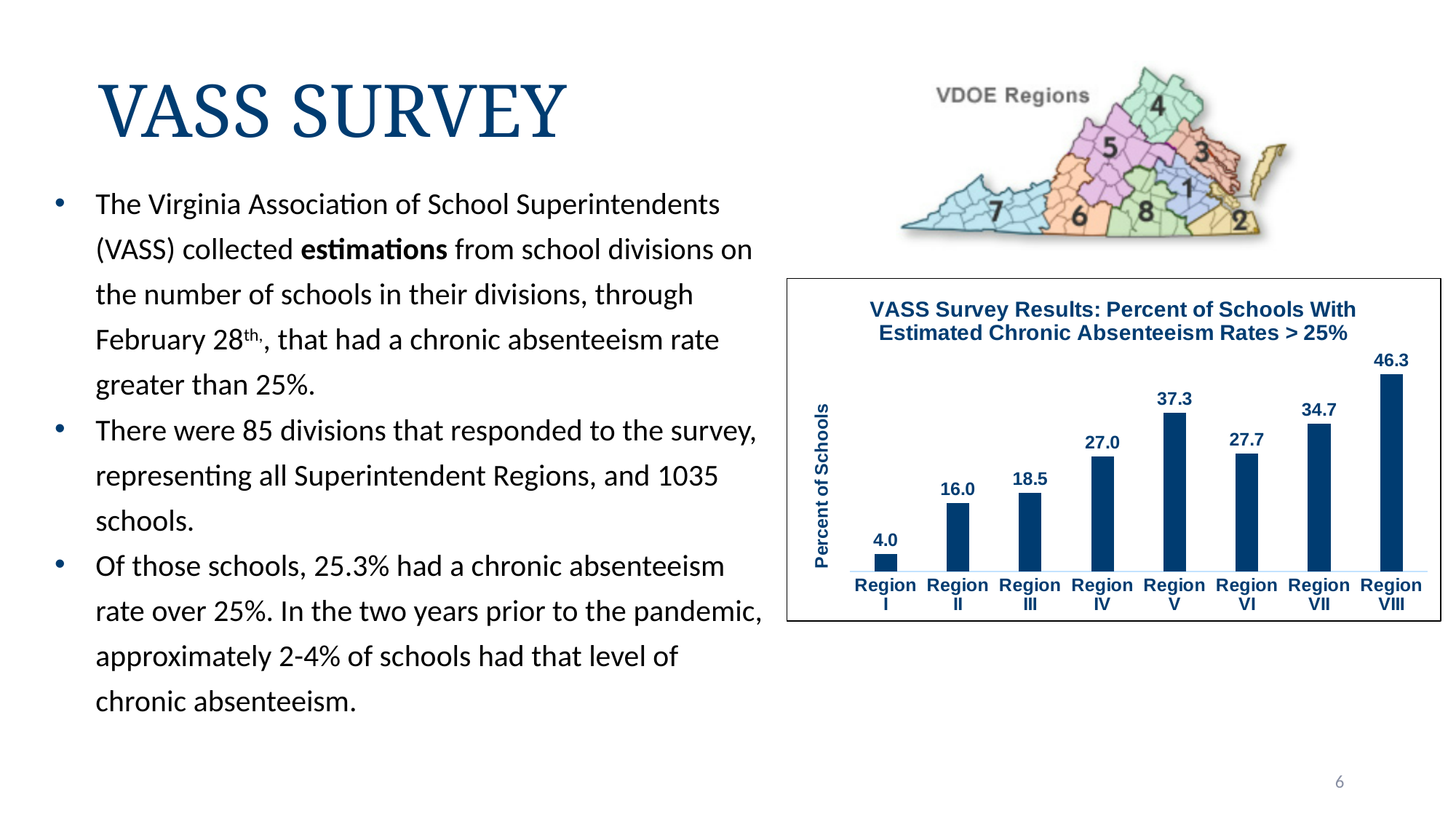
What is the title of the chart? VASS Survey Results: Percent of Schools With Estimated Chronic Absenteeism Rates > 25% What is the label on the vertical axis of the chart? Percent of Schools What is the difference between the values for Region VIII and Region VII? 11.6 Which region has the lowest percent of schools? Region I Which is larger, the value for Region IV or the value for Region VII? Region VII What is the difference between the values for Region III and Region II? 2.5 What is the value for Region I? 4.0 How many regions are shown in the chart? 8 Which region has the highest percent of schools? Region VIII What is the value for Region V? 37.3 What is the value for Region VI? 27.7 What kind of chart is shown on the slide? Bar chart